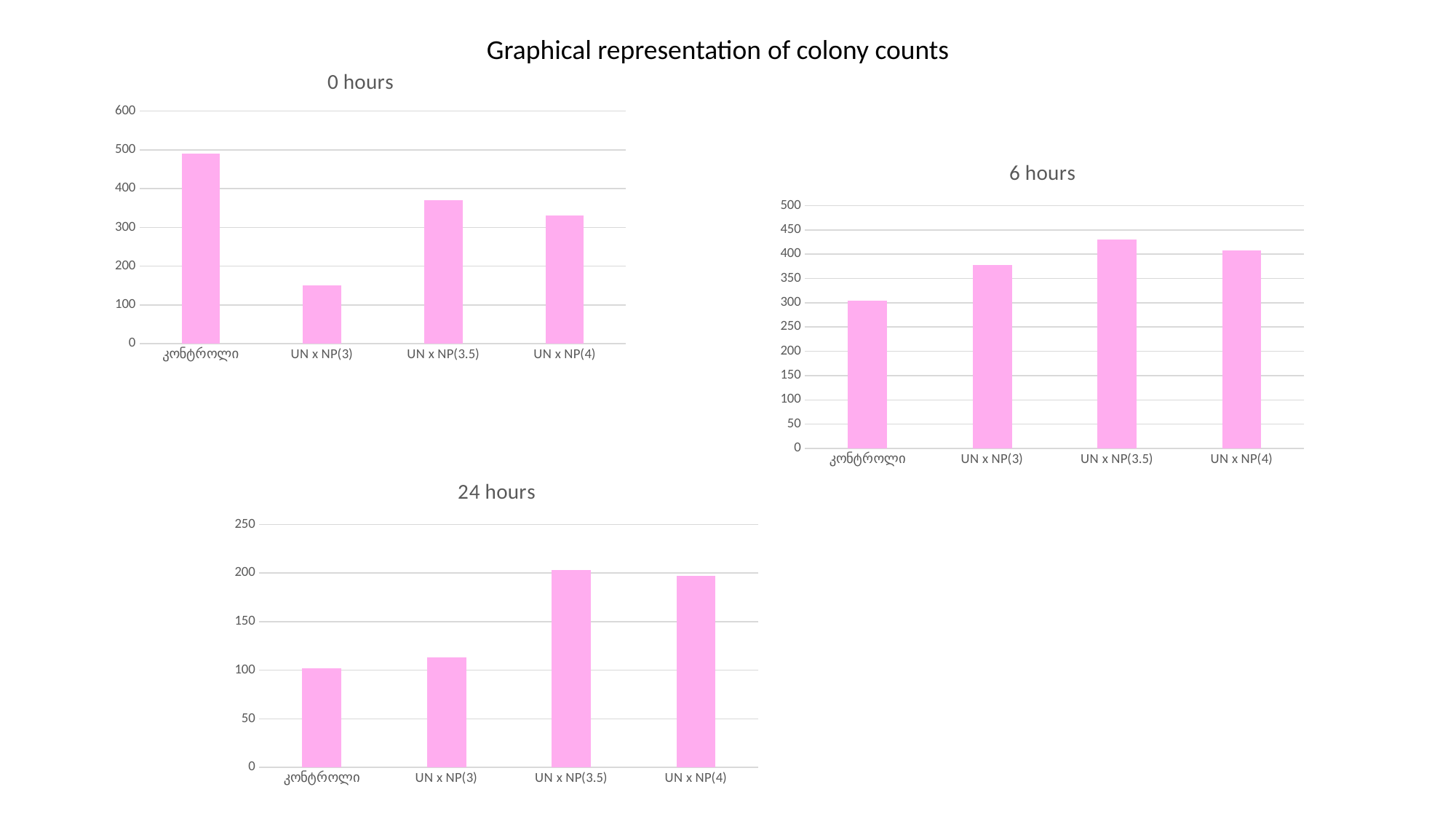
How many charts are on the slide? 3 How many categories are shown in the "24 hours" chart? 4 What kind of chart is the "0 hours" chart? bar chart In the "6 hours" chart, is the value for UN x NP(3.5) greater or less than 400? greater In the "0 hours" chart, is the value for UN x NP(3) greater or less than 200? less In the "0 hours" chart, which category has the highest value? კონტროლი In the "0 hours" chart, which is larger, UN x NP(3.5) or UN x NP(4)? UN x NP(3.5) In the "24 hours" chart, is the value for UN x NP(3.5) greater or less than 150? greater In the "6 hours" chart, which category has the highest value? UN x NP(3.5) In the "6 hours" chart, which category has the lowest value? კონტროლი In the "0 hours" chart, which category has the lowest value? UN x NP(3)